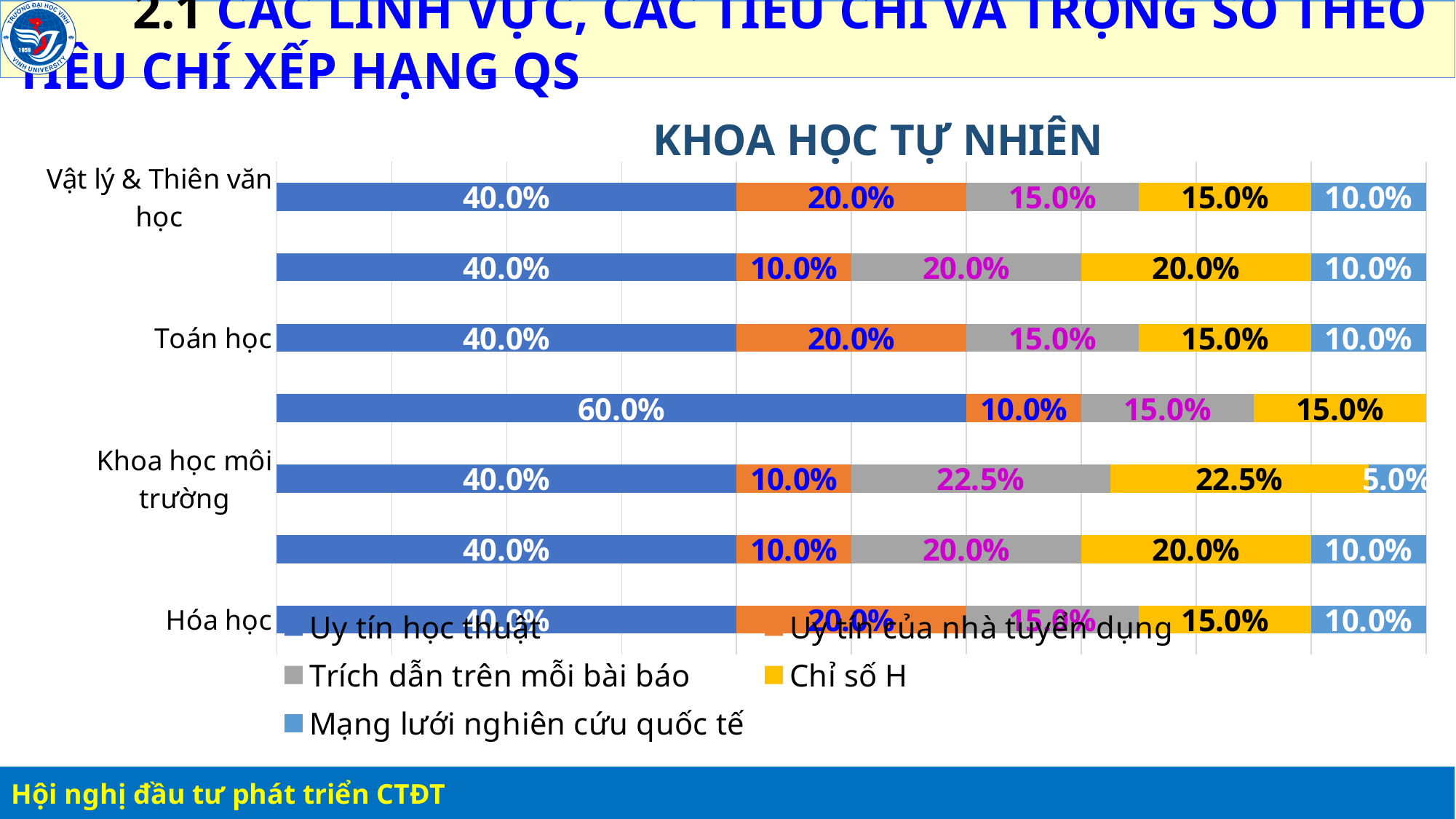
What is the value of Trích dẫn trên mỗi bài báo for Khoa học môi trường? 22.5% What is the title of the chart? KHOA HỌC TỰ NHIÊN For Vật lý & Thiên văn học, what is the difference between Uy tín học thuật and Uy tín của nhà tuyển dụng? 20.0% How many series does the legend of the chart list? 5 What is the value of Chỉ số H for Toán học? 15.0% For Khoa học môi trường, which is larger: Trích dẫn trên mỗi bài báo or Uy tín của nhà tuyển dụng? Trích dẫn trên mỗi bài báo What is the value of Uy tín học thuật for Vật lý & Thiên văn học? 40.0% What is the value of Mạng lưới nghiên cứu quốc tế for Khoa học môi trường? 5.0% What kind of chart is shown on the slide? bar chart How many bars are plotted in the chart? 7 What is the value of Uy tín của nhà tuyển dụng for Toán học? 20.0% Which series has the smallest value in the Khoa học môi trường bar? Mạng lưới nghiên cứu quốc tế